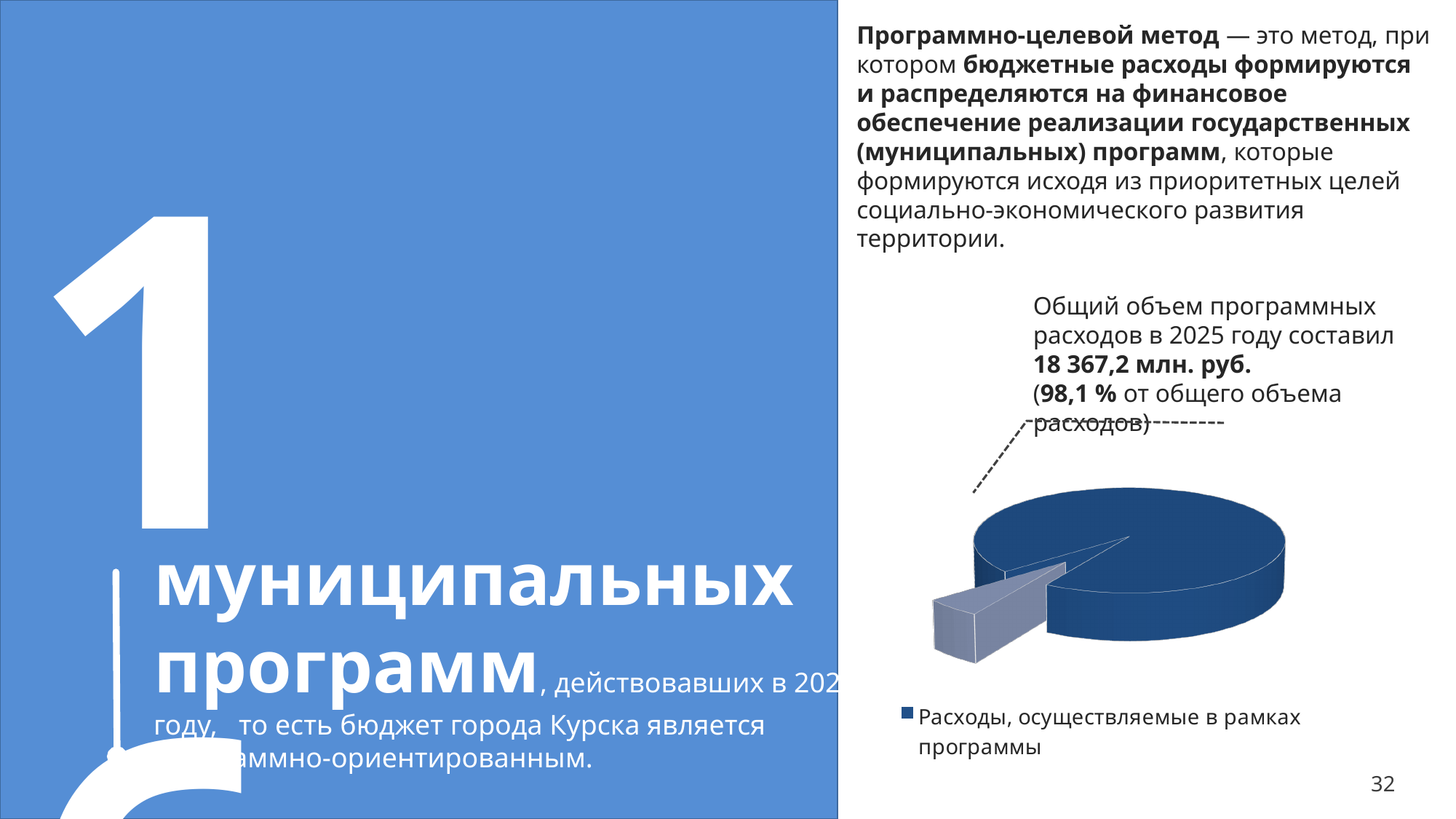
Which slice of the pie chart is larger: the dark blue slice or the grey exploded slice? The dark blue slice What colour is the slice representing expenses carried out within programs? Dark blue What is the total volume of program expenses in 2025 according to the callout on the pie chart? 18 367,2 млн. руб. Is the share of the dark blue slice (program expenses) greater or less than 90 %? greater What is the legend entry shown below the pie chart? Расходы, осуществляемые в рамках программы What share of total expenses does the large dark blue slice (program expenses) represent? 98,1 % How many slices does the pie chart contain? 2 For which year does the pie chart show the volume of program expenses? 2025 How many entries does the legend of the pie chart list? 1 What kind of chart is shown on the right side of the slide? Pie chart